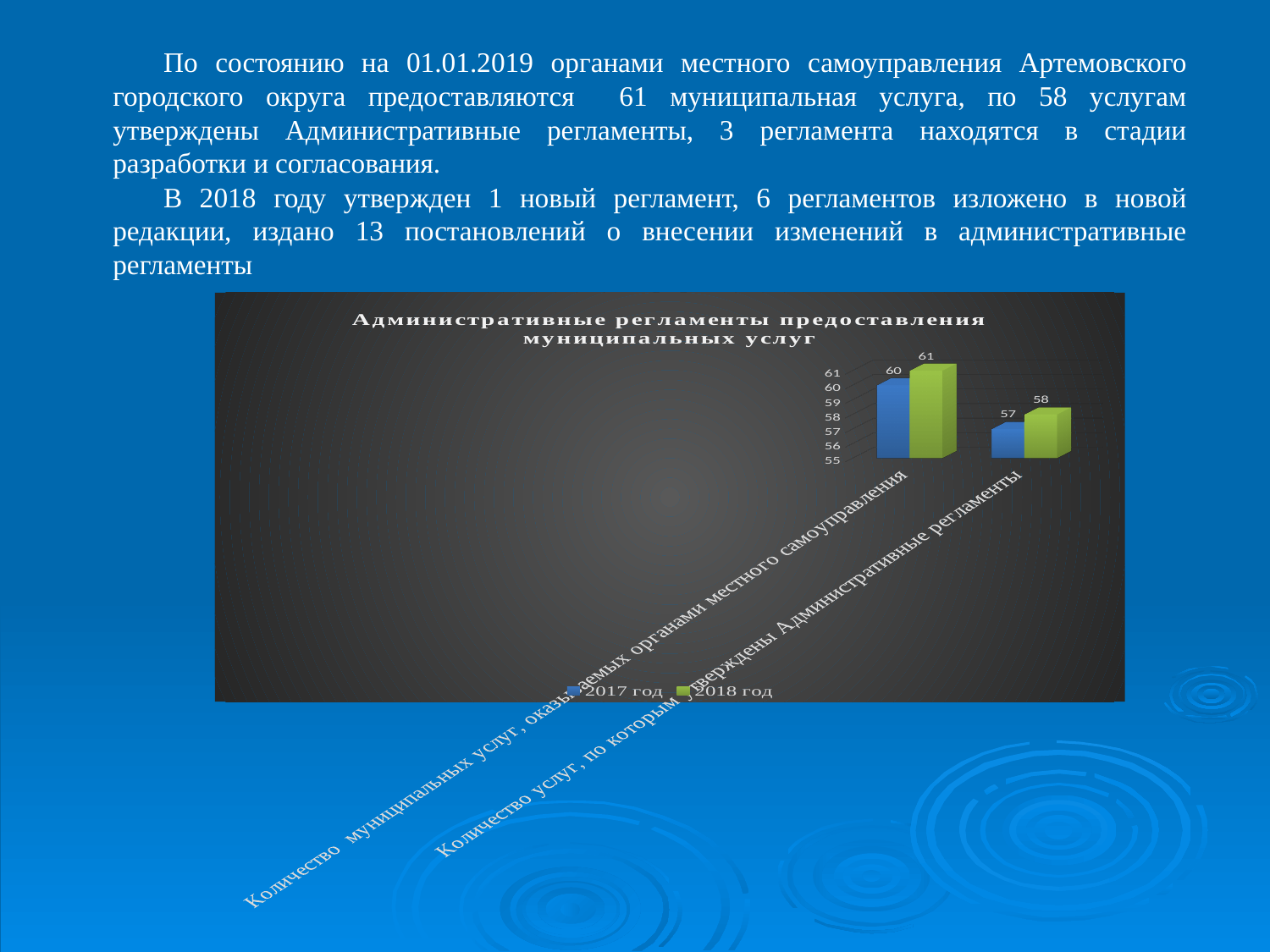
What is the value for 2017 год for 'Количество услуг, по которым утверждены Административные регламенты'? 57 What is the difference between the 2018 год and 2017 год values for 'Количество услуг, по которым утверждены Административные регламенты'? 1 What kind of chart is shown on the slide? Bar chart What is the value for 2018 год for 'Количество услуг, по которым утверждены Административные регламенты'? 58 What is the title of the chart? Административные регламенты предоставления муниципальных услуг What is the value for 2017 год for 'Количество муниципальных услуг, оказываемых органами местного самоуправления'? 60 What is the value for 2018 год for 'Количество муниципальных услуг, оказываемых органами местного самоуправления'? 61 Which category has the lowest value in the 2017 год series? Количество услуг, по которым утверждены Административные регламенты Which series has the larger value for 'Количество муниципальных услуг, оказываемых органами местного самоуправления': 2017 год or 2018 год? 2018 год What is the difference between the 2018 год values of the two categories? 3 How many series does the chart legend list? 2 How many categories are shown on the x axis of the chart? 2